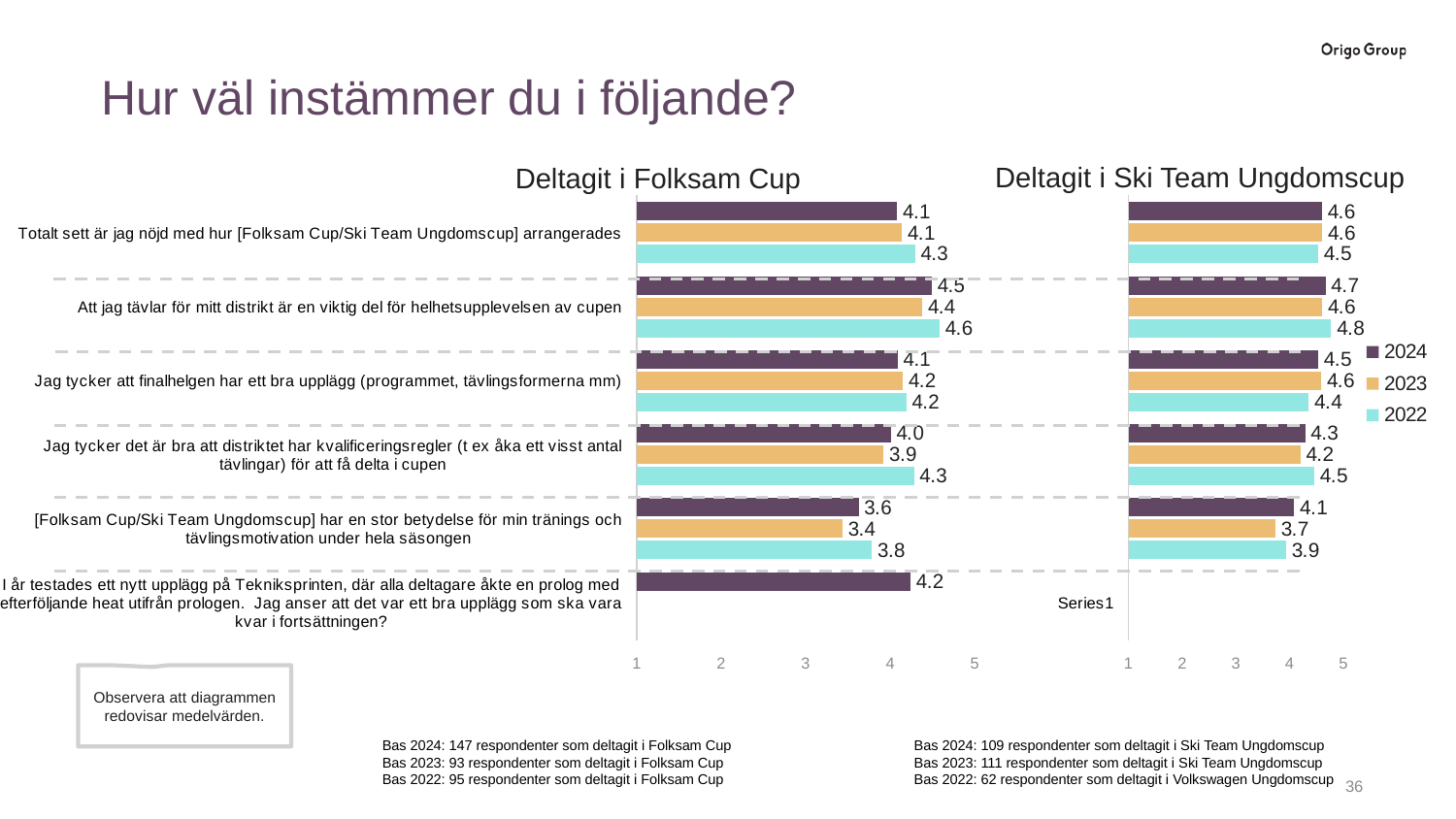
In the 'Deltagit i Ski Team Ungdomscup' chart, what is the 2022 value for 'Att jag tävlar för mitt distrikt är en viktig del för helhetsupplevelsen av cupen'? 4.8 What kind of chart is 'Deltagit i Folksam Cup'? Bar chart Which colour represents 2022 in the legend? Light blue In the 'Deltagit i Ski Team Ungdomscup' chart, which statement has the highest 2022 value? Att jag tävlar för mitt distrikt är en viktig del för helhetsupplevelsen av cupen In the 'Deltagit i Folksam Cup' chart, which statement has the lowest 2023 value? [Folksam Cup/Ski Team Ungdomscup] har en stor betydelse för min tränings och tävlingsmotivation under hela säsongen How many series does the legend list? 3 In the 'Deltagit i Folksam Cup' chart, what is the 2024 value for 'Totalt sett är jag nöjd med hur [Folksam Cup/Ski Team Ungdomscup] arrangerades'? 4.1 In the 'Deltagit i Folksam Cup' chart, which is larger for 'Jag tycker det är bra att distriktet har kvalificeringsregler': the 2022 value or the 2023 value? 2022 In the 'Deltagit i Folksam Cup' chart, is the 2023 value for '[Folksam Cup/Ski Team Ungdomscup] har en stor betydelse för min tränings och tävlingsmotivation under hela säsongen' greater or less than 4? less In the 'Deltagit i Folksam Cup' chart, what is the 2023 value for '[Folksam Cup/Ski Team Ungdomscup] har en stor betydelse för min tränings och tävlingsmotivation under hela säsongen'? 3.4 In the 'Deltagit i Folksam Cup' chart, what is the 2024 value for the statement about Tekniksprinten? 4.2 In the 'Deltagit i Ski Team Ungdomscup' chart, what is the difference between the 2024 and 2023 values for '[Folksam Cup/Ski Team Ungdomscup] har en stor betydelse för min tränings och tävlingsmotivation under hela säsongen'? 0.4